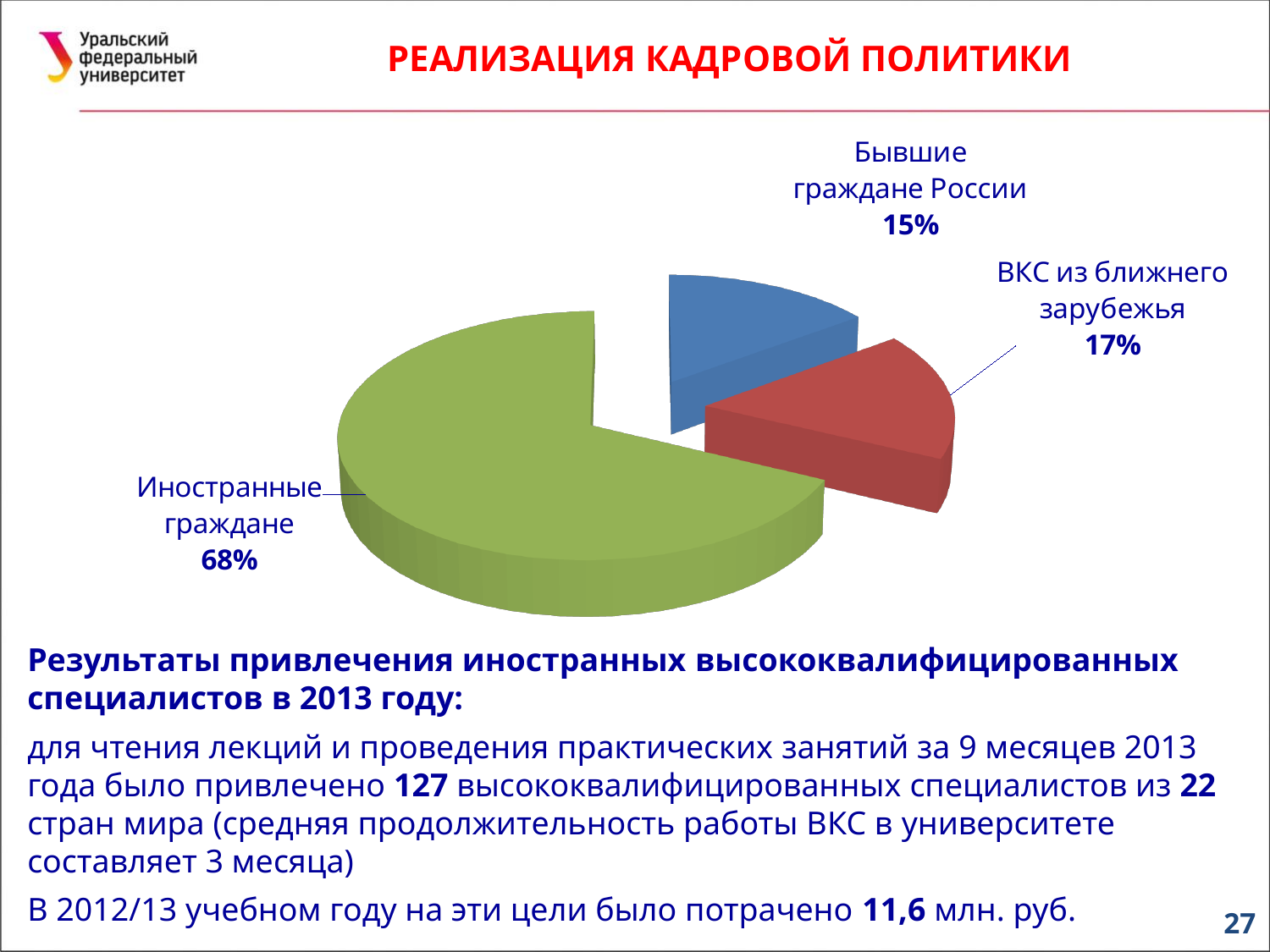
Which category has the smallest slice of the pie? Бывшие граждане России What is the difference in percentage points between "ВКС из ближнего зарубежья" and "Бывшие граждане России"? 2 What colour is the slice for "Иностранные граждане"? green Which is larger: the share for "ВКС из ближнего зарубежья" or for "Бывшие граждане России"? ВКС из ближнего зарубежья What share of the pie does "Бывшие граждане России" have? 15% What kind of chart is shown on the slide? pie chart What share of the pie does "ВКС из ближнего зарубежья" have? 17% What colour is the slice for "Бывшие граждане России"? blue What share of the pie does "Иностранные граждане" have? 68% What is the difference in percentage points between "Иностранные граждане" and "ВКС из ближнего зарубежья"? 51 How many slices does the pie chart have? 3 Which category has the largest slice of the pie? Иностранные граждане